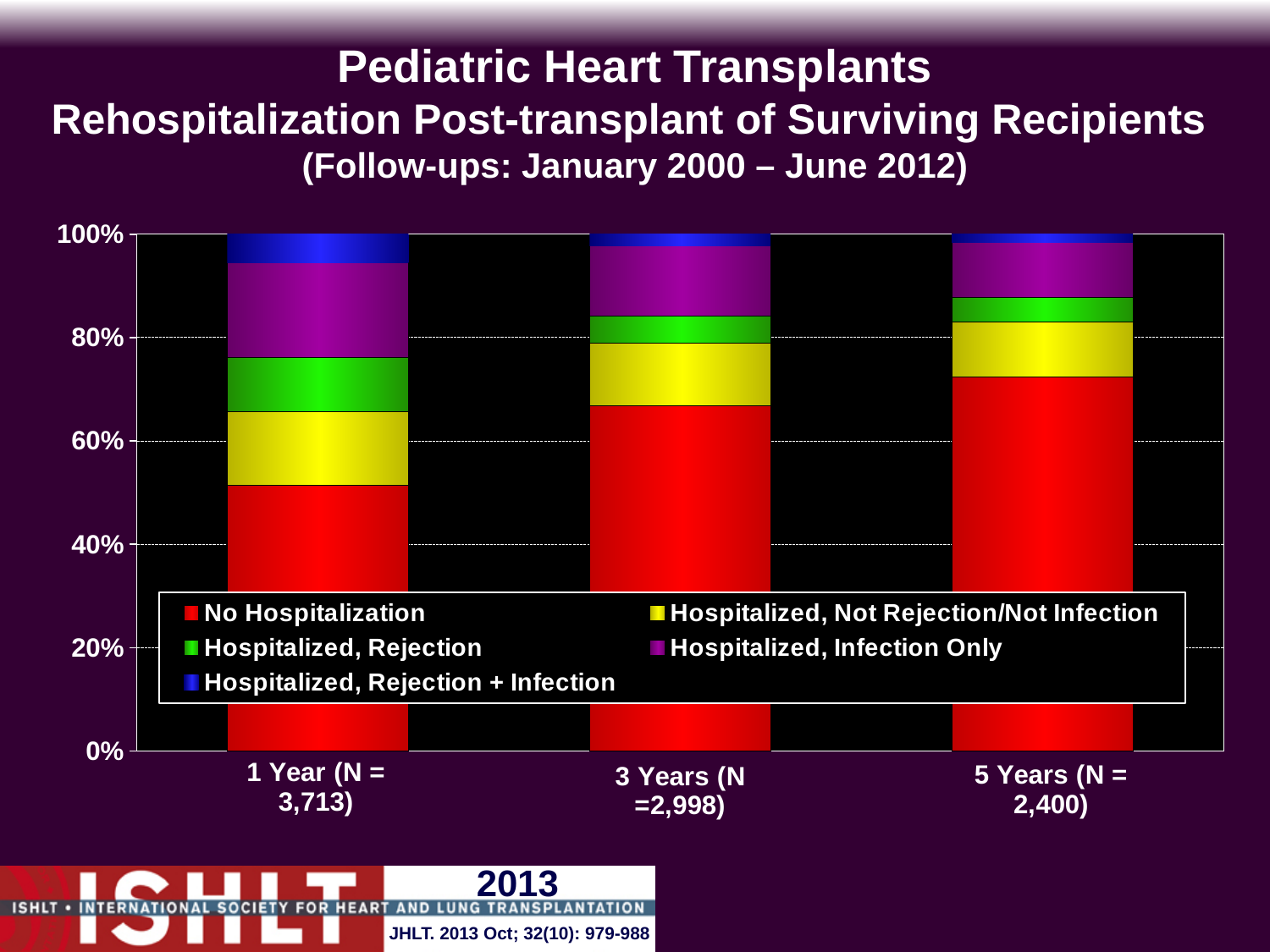
How many categories (follow-up time points) are shown on the x axis? 3 How many series does the legend list? 5 Which is larger: the No Hospitalization share at 1 Year or at 5 Years? 5 Years Is the value for No Hospitalization at 3 Years greater or less than 60%? greater Is the value for No Hospitalization at 1 Year greater or less than 60%? less At which follow-up time point is the No Hospitalization share highest? 5 Years (N = 2,400) What is the total of each stacked bar? 100% Which colour represents Hospitalized, Infection Only in the legend? Purple At which follow-up time point is the No Hospitalization share lowest? 1 Year (N = 3,713) What kind of chart is shown on the slide? Stacked bar chart Is the value for No Hospitalization at 5 Years greater or less than 60%? greater Does the No Hospitalization share rise or fall from 1 Year to 5 Years? rise